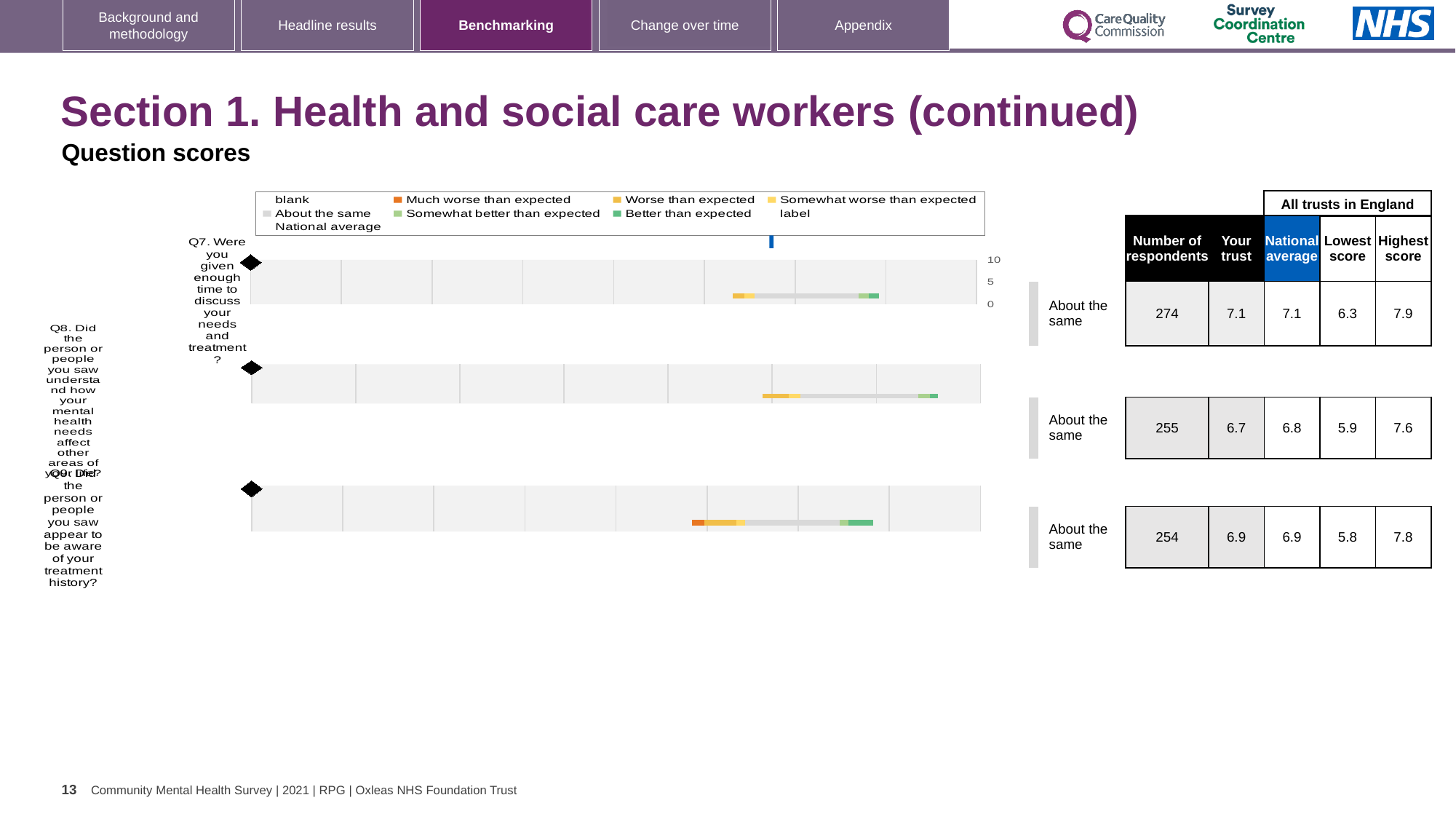
What kind of chart is used to show the question scores on this slide? bar chart Which question has the higher 'Your trust' score, Q7 or Q9? Q7 How many questions (Q7, Q8, Q9) are plotted as bars on the slide? 3 What benchmark category is shown next to the Q8 bar? About the same What is the highest score among all trusts in England for Q7? 7.9 How many entries does the legend above the charts list? 9 Which of the three questions has the lowest 'Lowest score' among all trusts in England? Q9 How many respondents answered Q9 (Did the person or people you saw appear to be aware of your treatment history?)? 254 What is the 'Your trust' score for Q7 (Were you given enough time to discuss your needs and treatment?)? 7.1 What is the national average score for Q8 (Did the person or people you saw understand how your mental health needs affect other areas of your life?)? 6.8 Which of the three questions has the highest 'Your trust' score? Q7 What is the difference between the highest and lowest trust scores for Q8? 1.7